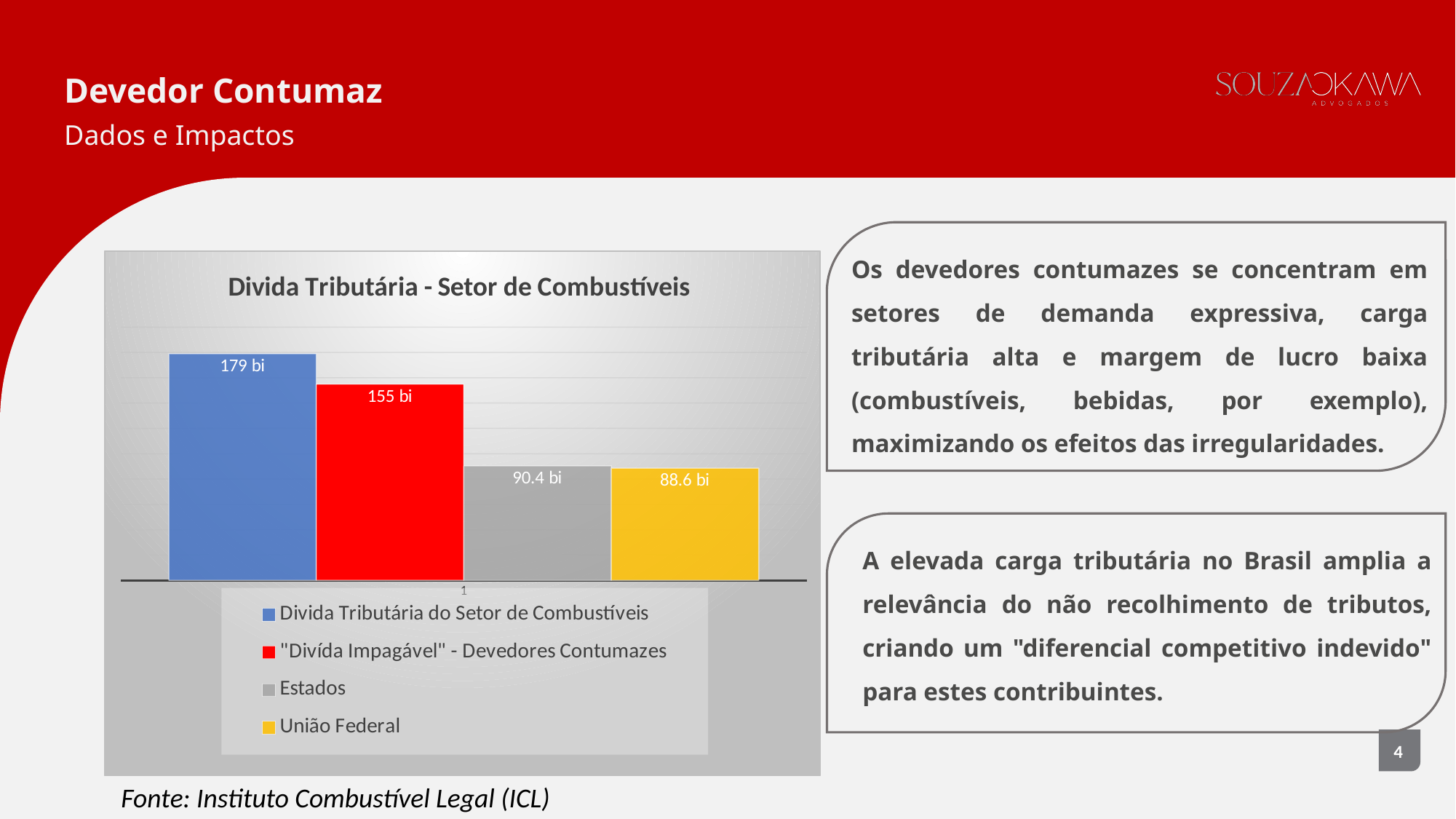
What is the value for União Federal? 88.6 bi Which is larger, the value for Estados or the value for União Federal? Estados Which series has the lowest value? União Federal Which series has the highest value? Divida Tributária do Setor de Combustíveis What is the value for "Divida Tributária do Setor de Combustíveis"? 179 bi What is the value for "Dívida Impagável" - Devedores Contumazes? 155 bi How many series does the legend list? 4 What is the difference between the value for "Divida Tributária do Setor de Combustíveis" and the value for "Dívida Impagável" - Devedores Contumazes? 24 bi What is the value for Estados? 90.4 bi What is the difference between the value for Estados and the value for União Federal? 1.8 bi What is the title of the chart? Divida Tributária - Setor de Combustíveis What kind of chart is shown on the slide? Bar chart